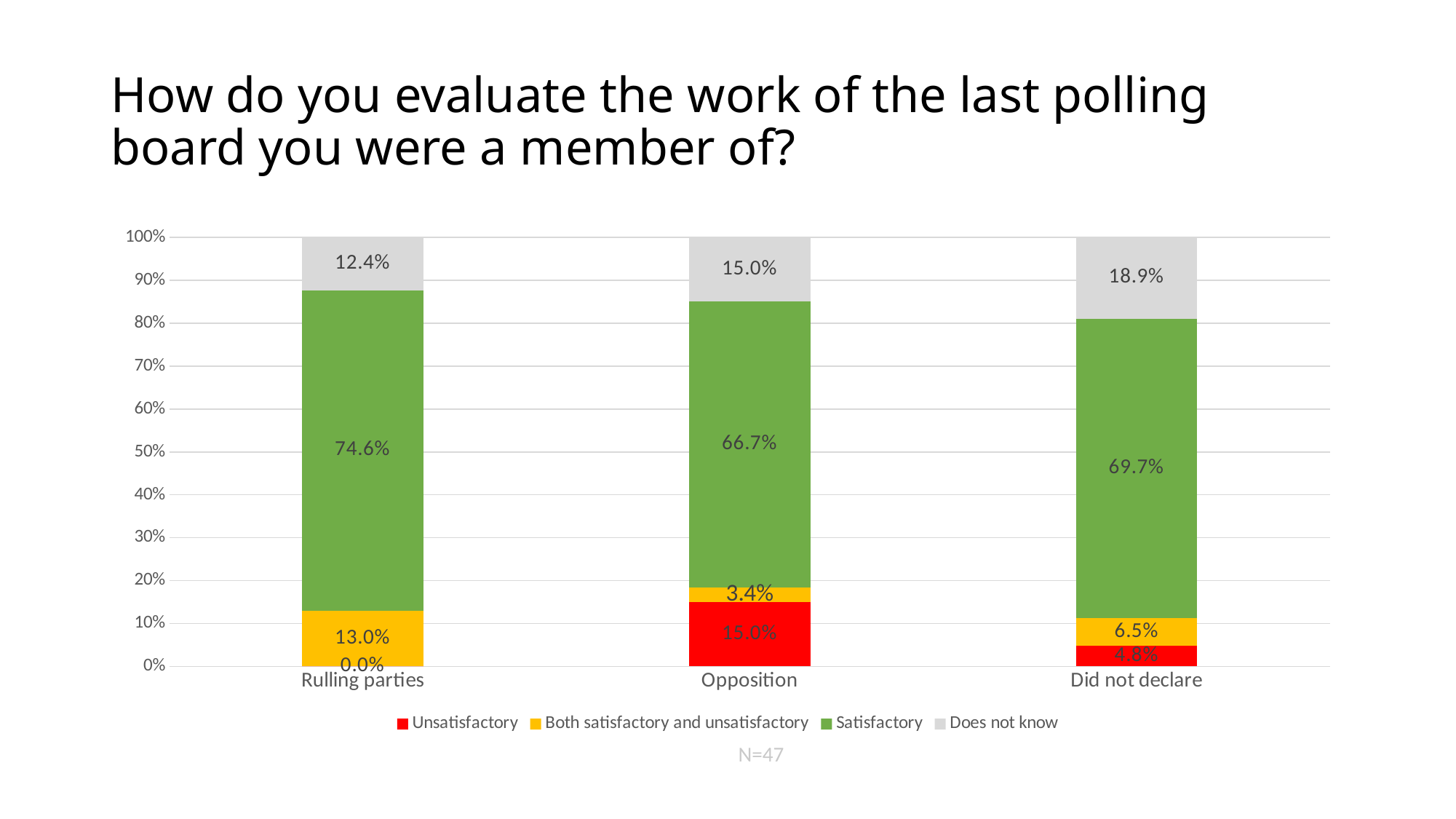
How many series does the legend list? 4 How many categories are shown on the x axis? 3 Which category has the lowest Unsatisfactory value? Rulling parties Which category has the highest Satisfactory value? Rulling parties What is the Both satisfactory and unsatisfactory value for Did not declare? 6.5% What colour represents the Satisfactory series? Green What is the Satisfactory value for Rulling parties? 74.6% What is the Unsatisfactory value for Opposition? 15.0% What is the difference between the Does not know values for Did not declare and Rulling parties? 6.5% What kind of chart is shown on the slide? Stacked bar chart What is the Does not know value for Did not declare? 18.9% Which is larger, the Both satisfactory and unsatisfactory value for Rulling parties or for Opposition? Rulling parties